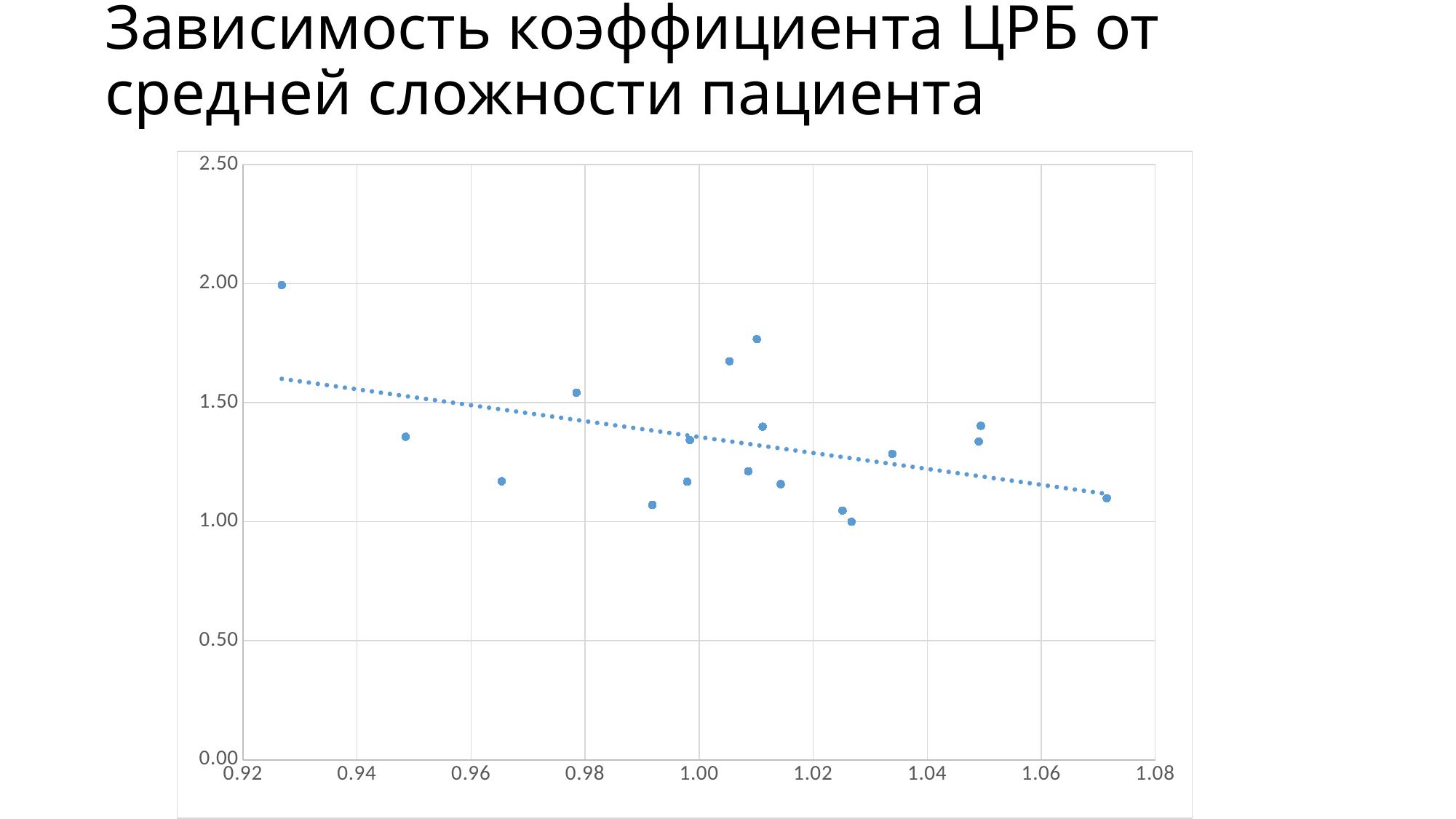
What is the title of the chart on the slide? Зависимость коэффициента ЦРБ от средней сложности пациента What kind of chart is shown on the slide? Scatter chart How many data points are plotted on the chart? 18 Is the value of the point near x = 0.99 (the lowest point in that area) greater or less than 1.50? less Which is larger: the value of the leftmost point (near x = 0.92) or the value of the rightmost point (near x = 1.07)? The leftmost point Is the value of the rightmost point (near x = 1.07) greater or less than 1.50? less Does the dotted trend line rise or fall as the x-axis value increases? Falls What is the maximum value shown on the y-axis? 2.50 Is the value of the leftmost point (near x = 0.92) greater or less than 1.50? greater